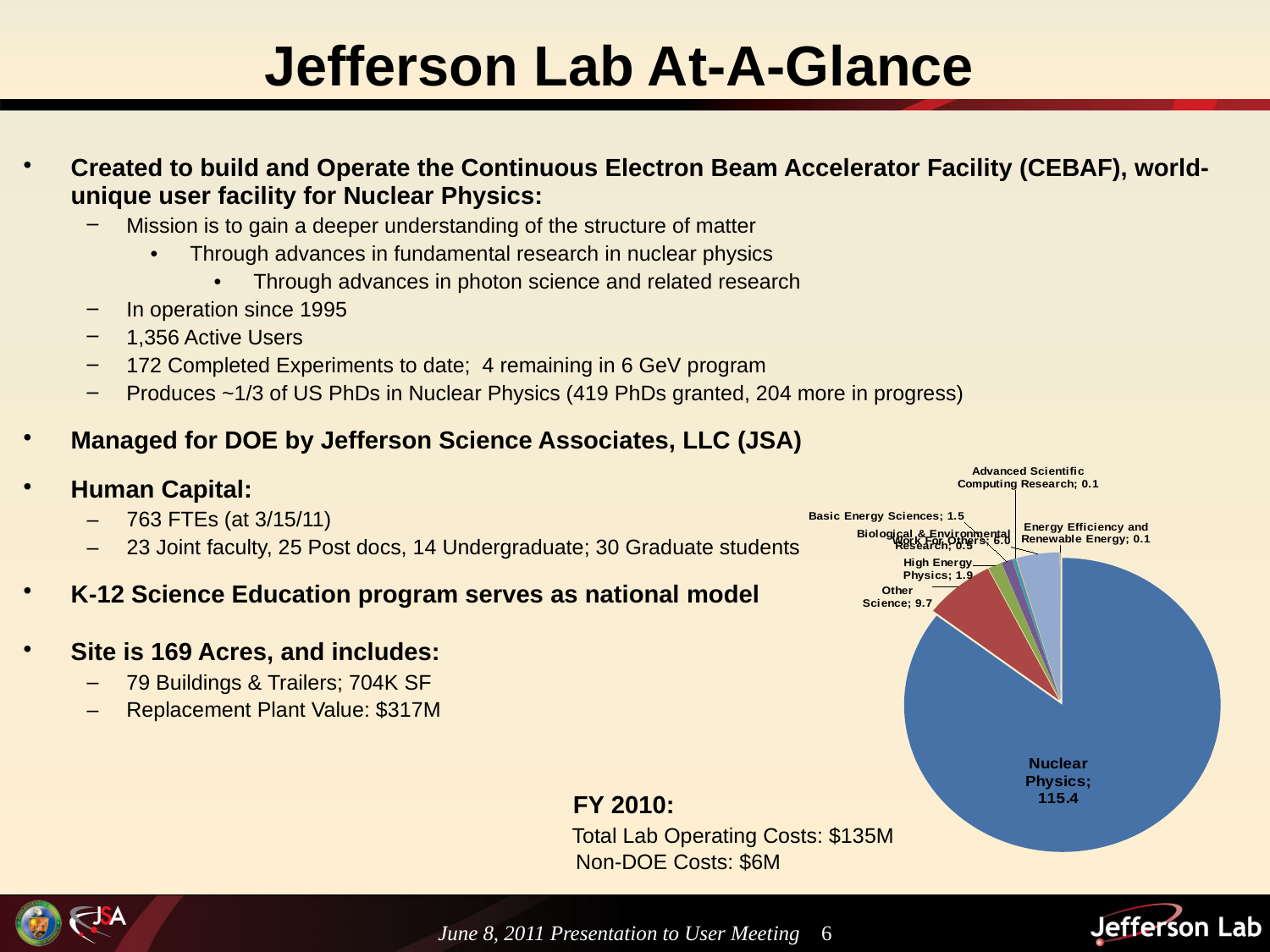
What is the value for Basic Energy Sciences in the pie chart? 1.5 What kind of chart is shown on the slide? pie chart Which category has the largest slice of the pie chart? Nuclear Physics What is the value for Other Science in the pie chart? 9.7 What is the value for High Energy Physics in the pie chart? 1.9 How many categories are labelled in the pie chart? 8 What colour is the Nuclear Physics slice in the pie chart? blue What is the value for Nuclear Physics in the pie chart? 115.4 What is the value for Advanced Scientific Computing Research in the pie chart? 0.1 Which is larger, the value for High Energy Physics or the value for Basic Energy Sciences? High Energy Physics What is the difference between the values for Nuclear Physics and Other Science? 105.7 What is the difference between the values for Other Science and High Energy Physics? 7.8